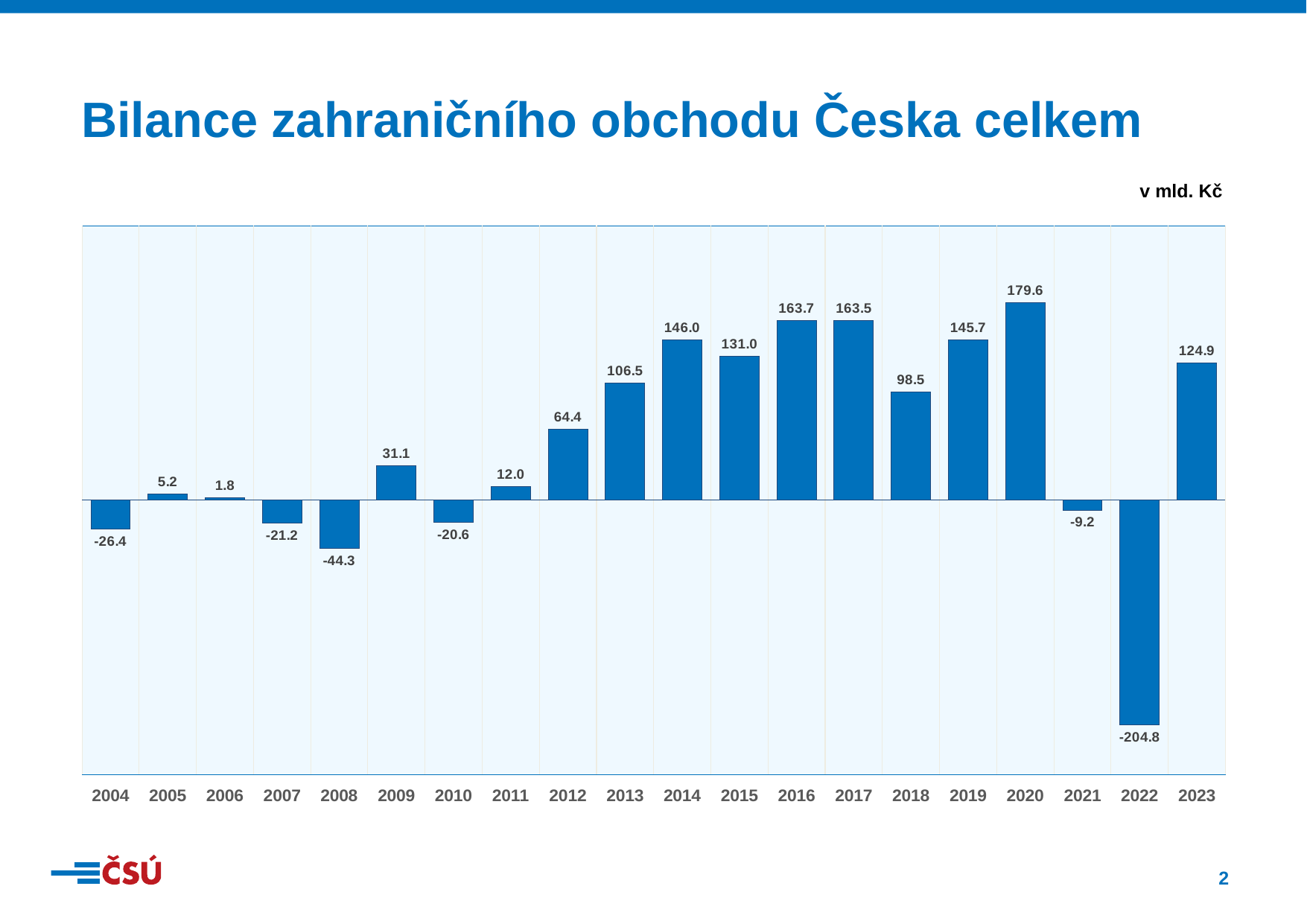
How many years are shown on the x axis? 20 Which year has the lowest value? 2022 Which year has the highest value? 2020 What is the difference between the values for 2020 and 2019? 33.9 What kind of chart is shown on the slide? bar chart Do the values rise or fall from 2012 to 2016? rise What is the value for 2008? -44.3 What is the difference between the values for 2023 and 2022? 329.7 What is the value for 2020? 179.6 What is the value for 2022? -204.8 What is the value for 2023? 124.9 Which is larger, the value for 2014 or the value for 2015? 2014